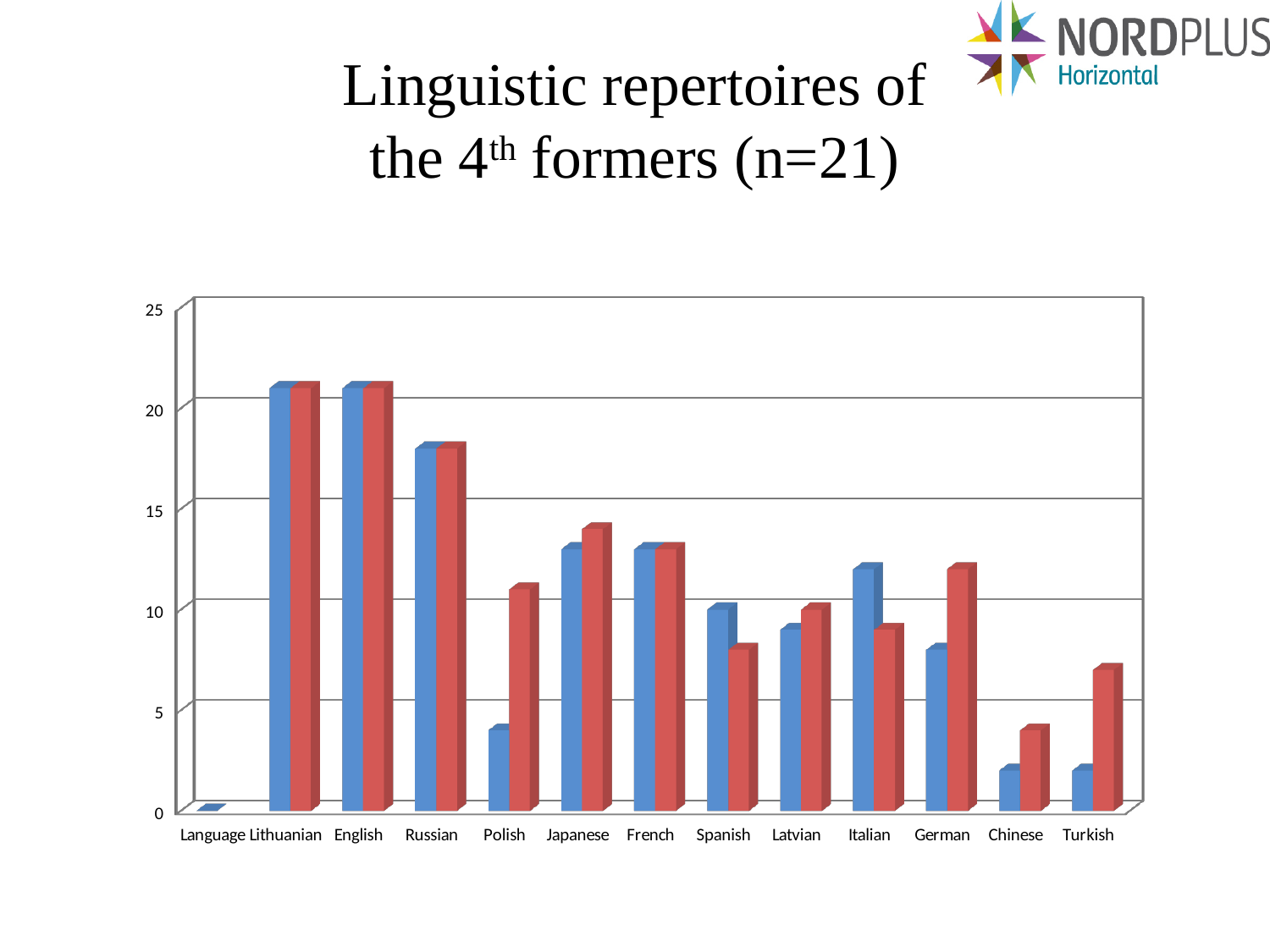
Is the blue bar for Russian greater or less than 15? greater Is the blue bar for Chinese greater or less than 5? less For Italian, which bar is taller, the blue one or the red one? blue What is the title of the slide containing the chart? Linguistic repertoires of the 4th formers (n=21) Is the blue bar for Polish greater or less than 5? less How many differently coloured bar series are plotted for each language? 2 What kind of chart is shown on the slide? bar chart For Polish, which bar is taller, the blue one or the red one? red For German, which bar is taller, the blue one or the red one? red